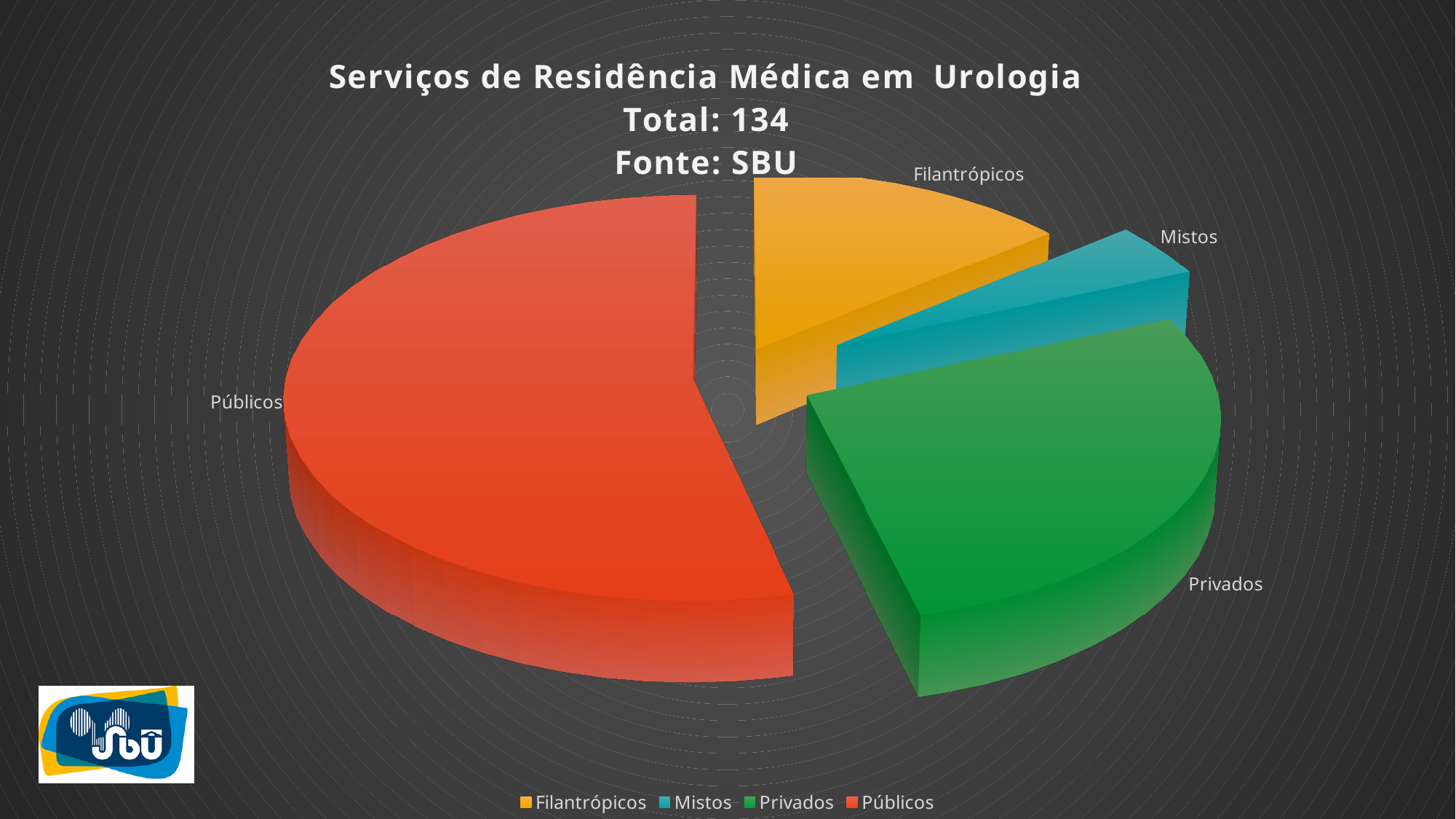
Which category has the largest slice of the pie? Públicos How many entries does the legend list? 4 What source (Fonte) is given in the chart title? SBU Which slice is larger, Filantrópicos or Mistos? Filantrópicos What kind of chart is shown on the slide? Pie chart How many slices does the pie chart have? 4 What total is stated in the chart title? 134 Which category has the smallest slice of the pie? Mistos Which slice is larger, Públicos or Privados? Públicos Which slice is larger, Privados or Filantrópicos? Privados